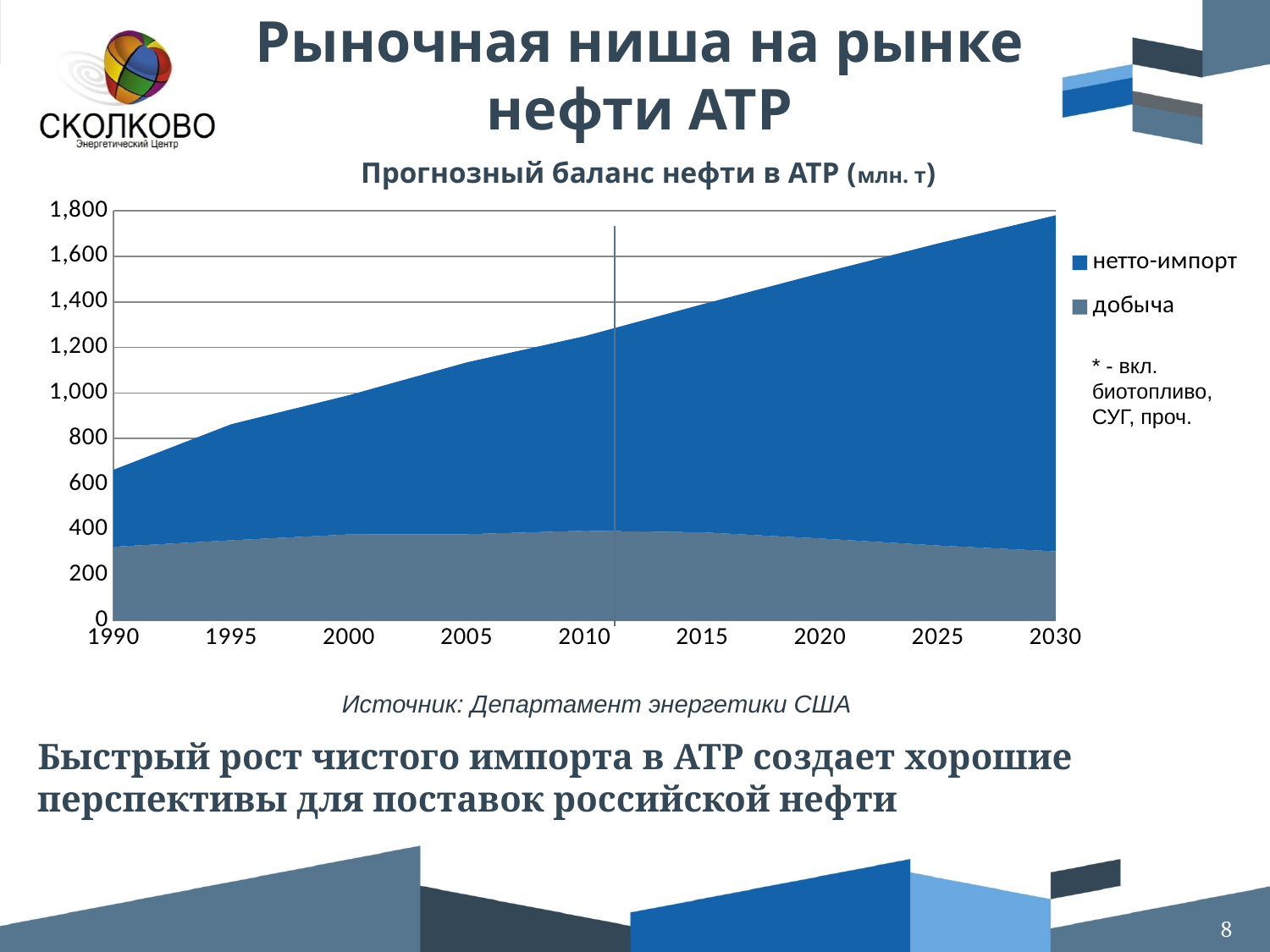
Does the total oil balance (top of the stacked area) rise or fall from 1990 to 2030? rise Which is larger, the total oil balance in 2030 or in 1990? 2030 Is the total value (top of the stacked area) in 1990 greater or less than 800? less What is the highest value shown on the y axis? 1,800 How many series does the legend list? 2 What is the title of the chart? Прогнозный баланс нефти в АТР (млн. т) What are the two series named in the legend? нетто-импорт and добыча Is the total value (top of the stacked area) in 2030 greater or less than 1,600? greater Is the value for добыча in 1990 greater or less than 400? less What kind of chart is shown on the slide? stacked area chart How many year labels are shown on the x axis? 9